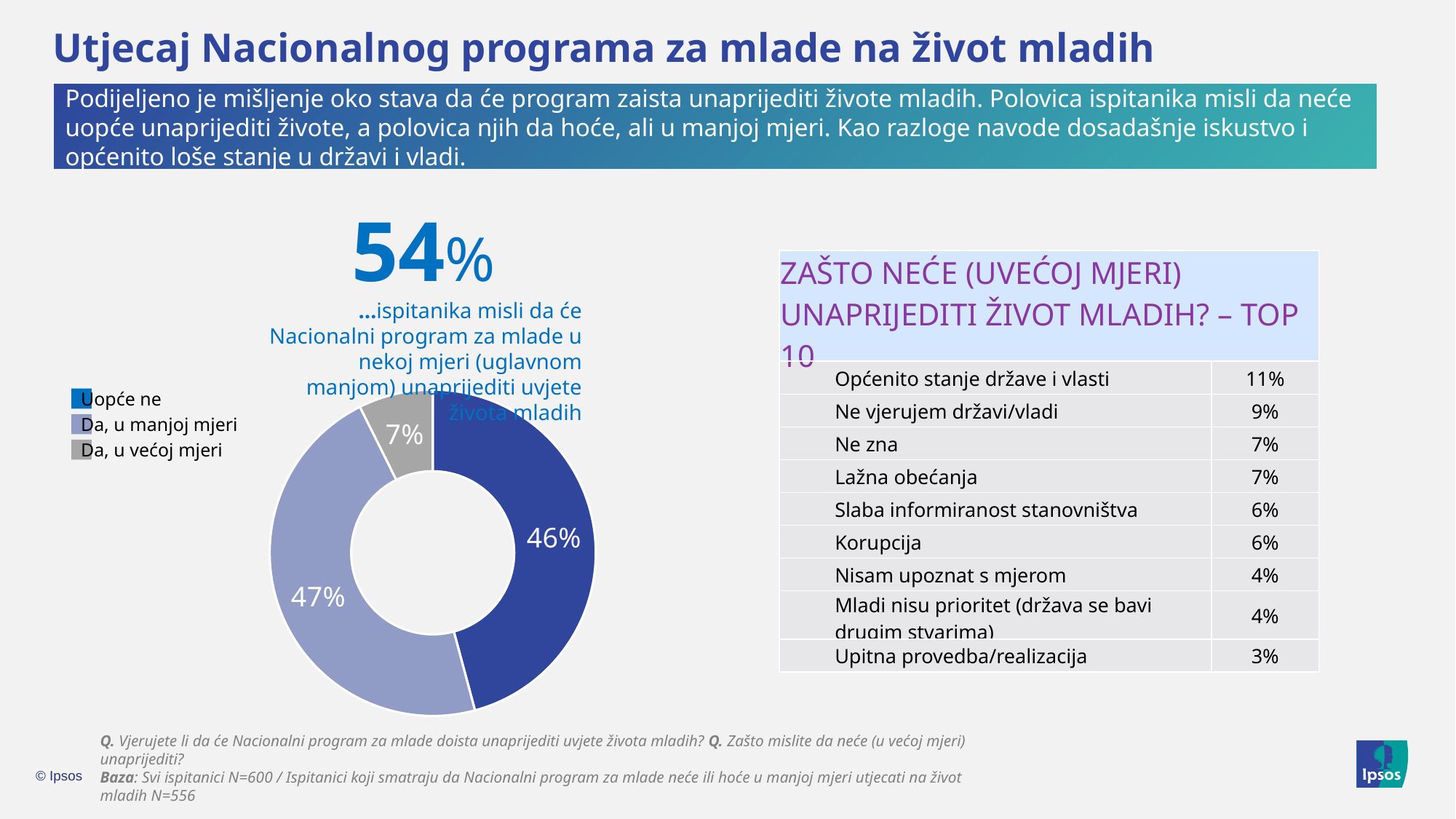
What large number is displayed above the donut chart? 54% What kind of chart is shown on the left of the slide? Pie (donut) chart What colour is the "Uopće ne" slice in the donut chart? Dark blue What percentage of respondents answered "Da, u manjoj mjeri" in the donut chart? 47% What is the difference in percentage points between "Da, u manjoj mjeri" and "Da, u većoj mjeri" in the donut chart? 40 percentage points What is the combined share of "Da, u manjoj mjeri" and "Da, u većoj mjeri" in the donut chart? 54% What is the difference in percentage points between "Uopće ne" and "Da, u većoj mjeri" in the donut chart? 39 percentage points What percentage of respondents answered "Uopće ne" in the donut chart? 46% How many categories does the donut chart show? 3 What share of the donut chart is taken by "Da, u većoj mjeri"? 7% Which slice is larger in the donut chart: "Uopće ne" or "Da, u većoj mjeri"? Uopće ne Which category has the smallest slice in the donut chart? Da, u većoj mjeri